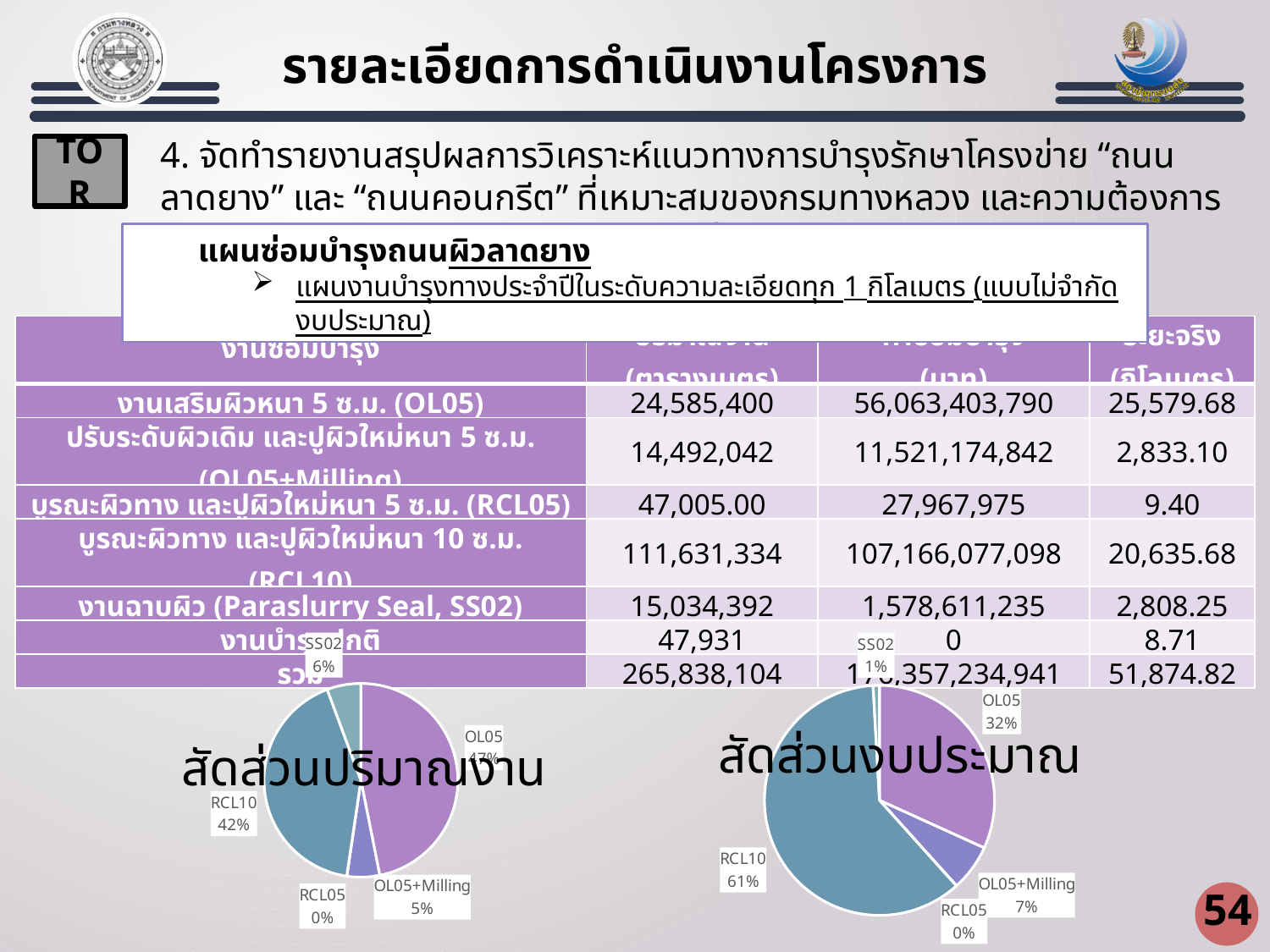
In the right chart titled สัดส่วนงบประมาณ, what share does RCL10 have? 61% In the right chart titled สัดส่วนงบประมาณ, what share does OL05+Milling have? 7% In the right chart titled สัดส่วนงบประมาณ, which is larger, OL05 or OL05+Milling? OL05 In the left chart titled สัดส่วนปริมาณงาน, what share does SS02 have? 6% What kind of chart is the left chart titled สัดส่วนปริมาณงาน? pie chart In the right chart titled สัดส่วนงบประมาณ, what share does OL05 have? 32% In the left chart titled สัดส่วนปริมาณงาน, what share does RCL10 have? 42% In the left chart titled สัดส่วนปริมาณงาน, what share does OL05+Milling have? 5% In the right chart titled สัดส่วนงบประมาณ, which category has the largest slice? RCL10 How many categories are labelled in the right chart titled สัดส่วนงบประมาณ? 5 In the right chart titled สัดส่วนงบประมาณ, how many percentage points larger is RCL10 than OL05? 29 In the right chart titled สัดส่วนงบประมาณ, what share does SS02 have? 1%